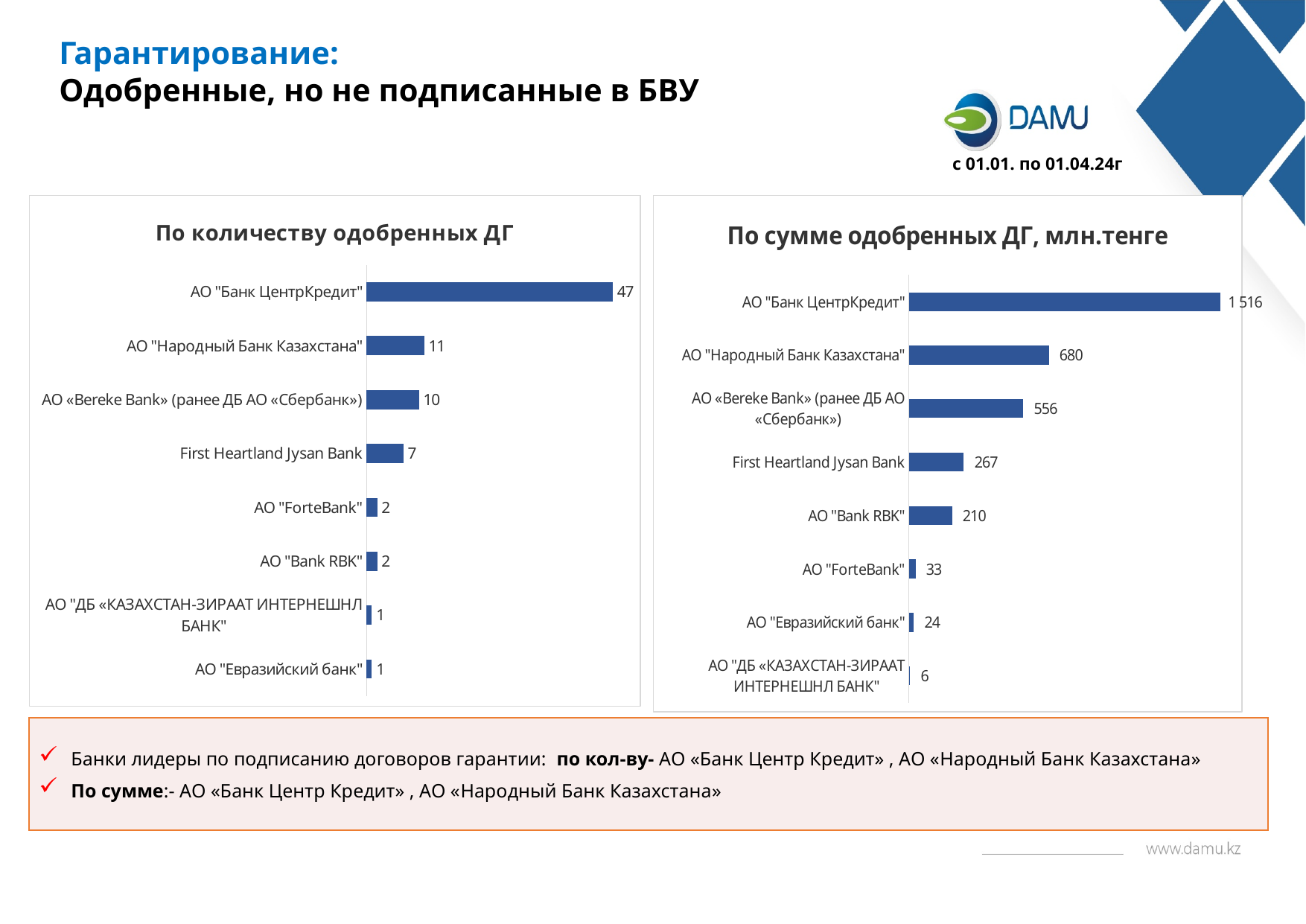
In the chart "По сумме одобренных ДГ, млн.тенге", which bank has the lowest value? АО "ДБ «КАЗАХСТАН-ЗИРААТ ИНТЕРНЕШНЛ БАНК" In the chart "По количеству одобренных ДГ", what is the value for АО "Банк ЦентрКредит"? 47 What is the title of the chart on the left side of the slide? По количеству одобренных ДГ In the chart "По количеству одобренных ДГ", what is the difference between АО "Банк ЦентрКредит" and АО "Народный Банк Казахстана"? 36 In the chart "По сумме одобренных ДГ, млн.тенге", which is larger: АО "ForteBank" or АО "Евразийский банк"? АО "ForteBank" How many banks are shown in the chart "По количеству одобренных ДГ"? 8 In the chart "По сумме одобренных ДГ, млн.тенге", what is the value for АО "Bank RBK"? 210 In the chart "По сумме одобренных ДГ, млн.тенге", which bank has the highest value? АО "Банк ЦентрКредит" In the chart "По сумме одобренных ДГ, млн.тенге", what is the value for АО "Народный Банк Казахстана"? 680 In the chart "По сумме одобренных ДГ, млн.тенге", what is the difference between АО "Народный Банк Казахстана" and АО «Bereke Bank» (ранее ДБ АО «Сбербанк»)? 124 What type of chart is "По сумме одобренных ДГ, млн.тенге"? Bar chart In the chart "По количеству одобренных ДГ", what is the value for First Heartland Jysan Bank? 7